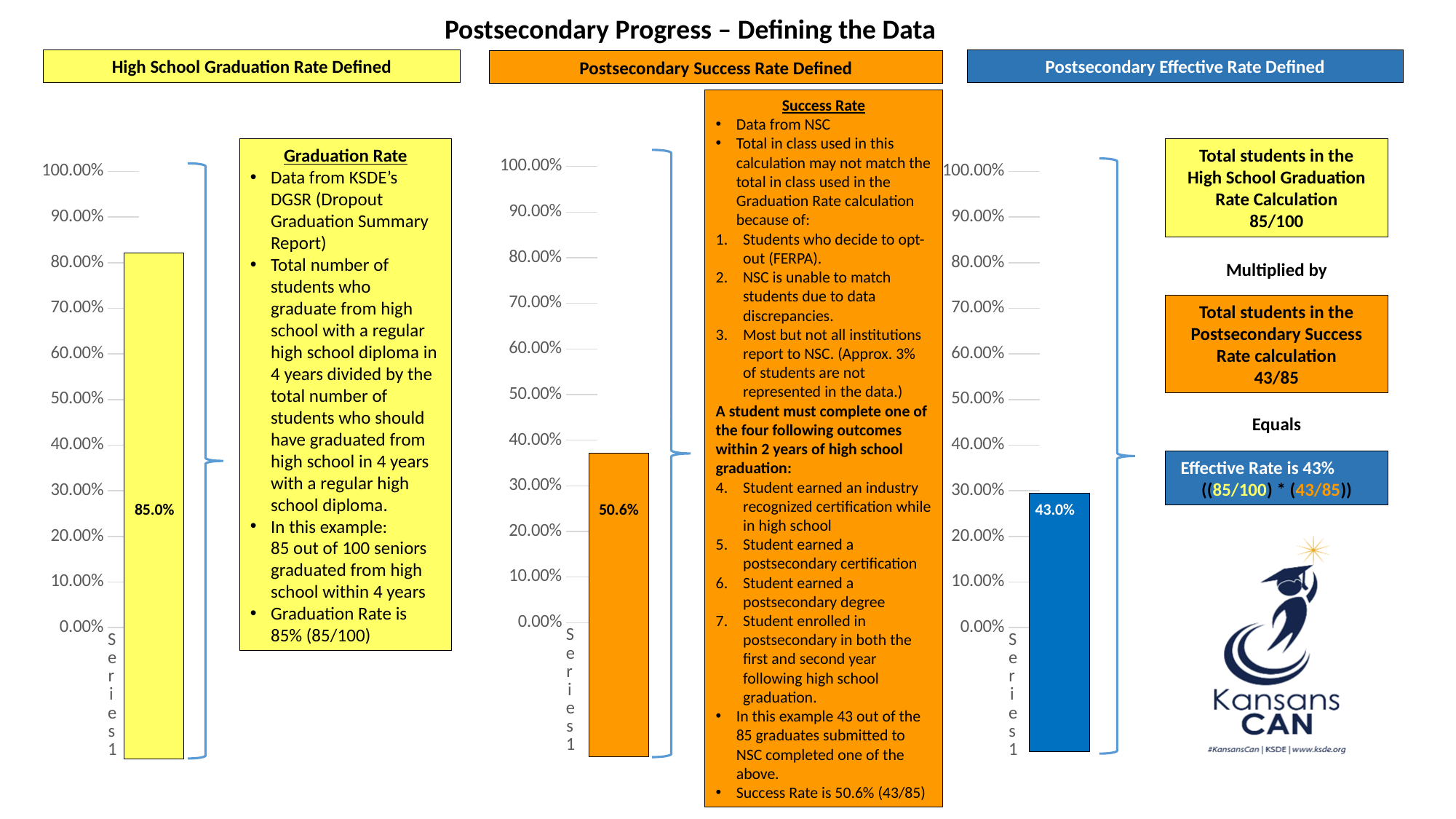
On the middle chart under 'Postsecondary Success Rate Defined', what value is shown on the bar? 50.6% What is the difference between the bar value on the middle chart (50.6%) and the bar value on the right chart (43.0%)? 7.6% What kind of chart is the left chart under 'High School Graduation Rate Defined'? bar chart What is the category label shown below the bar on the right chart under 'Postsecondary Effective Rate Defined'? Series 1 What is the difference between the bar value on the left chart (85.0%) and the bar value on the middle chart (50.6%)? 34.4% On the left chart under 'High School Graduation Rate Defined', is the bar value greater or less than 80.00%? greater On the right chart under 'Postsecondary Effective Rate Defined', is the bar value greater or less than 50.00%? less On the left chart under 'High School Graduation Rate Defined', what value is shown on the bar? 85.0% On the middle chart under 'Postsecondary Success Rate Defined', is the bar value greater or less than 60.00%? less Which is larger: the bar on the left chart (High School Graduation Rate) or the bar on the right chart (Postsecondary Effective Rate)? the left chart (85.0%) How many bars are plotted on the middle chart under 'Postsecondary Success Rate Defined'? 1 On the right chart under 'Postsecondary Effective Rate Defined', what value is shown on the bar? 43.0%